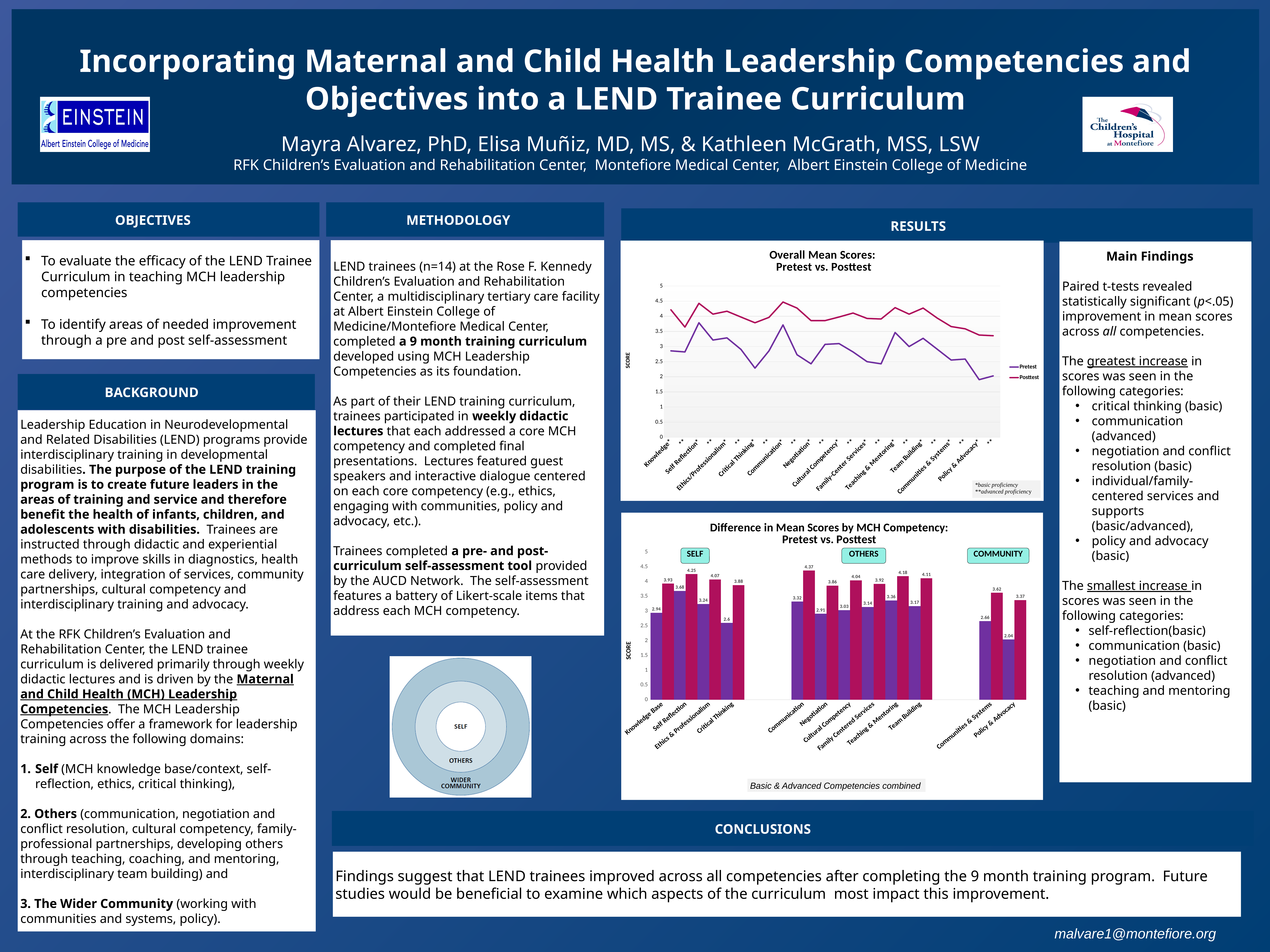
In the 'Difference in Mean Scores by MCH Competency' chart, what is the difference between the magenta and purple bars for Critical Thinking? 1.28 In the 'Difference in Mean Scores by MCH Competency' chart, is the purple bar for Self Reflection larger or smaller than the purple bar for Knowledge Base? larger In the 'Difference in Mean Scores by MCH Competency' chart, which competency has the highest magenta bar? Communication In the 'Difference in Mean Scores by MCH Competency' chart, what is the value of the purple bar for Policy & Advocacy? 2.04 What type of chart is the 'Overall Mean Scores: Pretest vs. Posttest' chart? line chart What type of chart is the 'Difference in Mean Scores by MCH Competency' chart? bar chart How many competencies are shown on the x axis of the 'Difference in Mean Scores by MCH Competency' chart? 12 How many series does the legend of the 'Overall Mean Scores: Pretest vs. Posttest' chart list? 2 In the 'Difference in Mean Scores by MCH Competency' chart, what is the value of the purple bar for Critical Thinking? 2.6 In the 'Difference in Mean Scores by MCH Competency' chart, what is the value of the magenta bar for Communication? 4.37 In the 'Difference in Mean Scores by MCH Competency' chart, which competency has the lowest purple bar? Policy & Advocacy